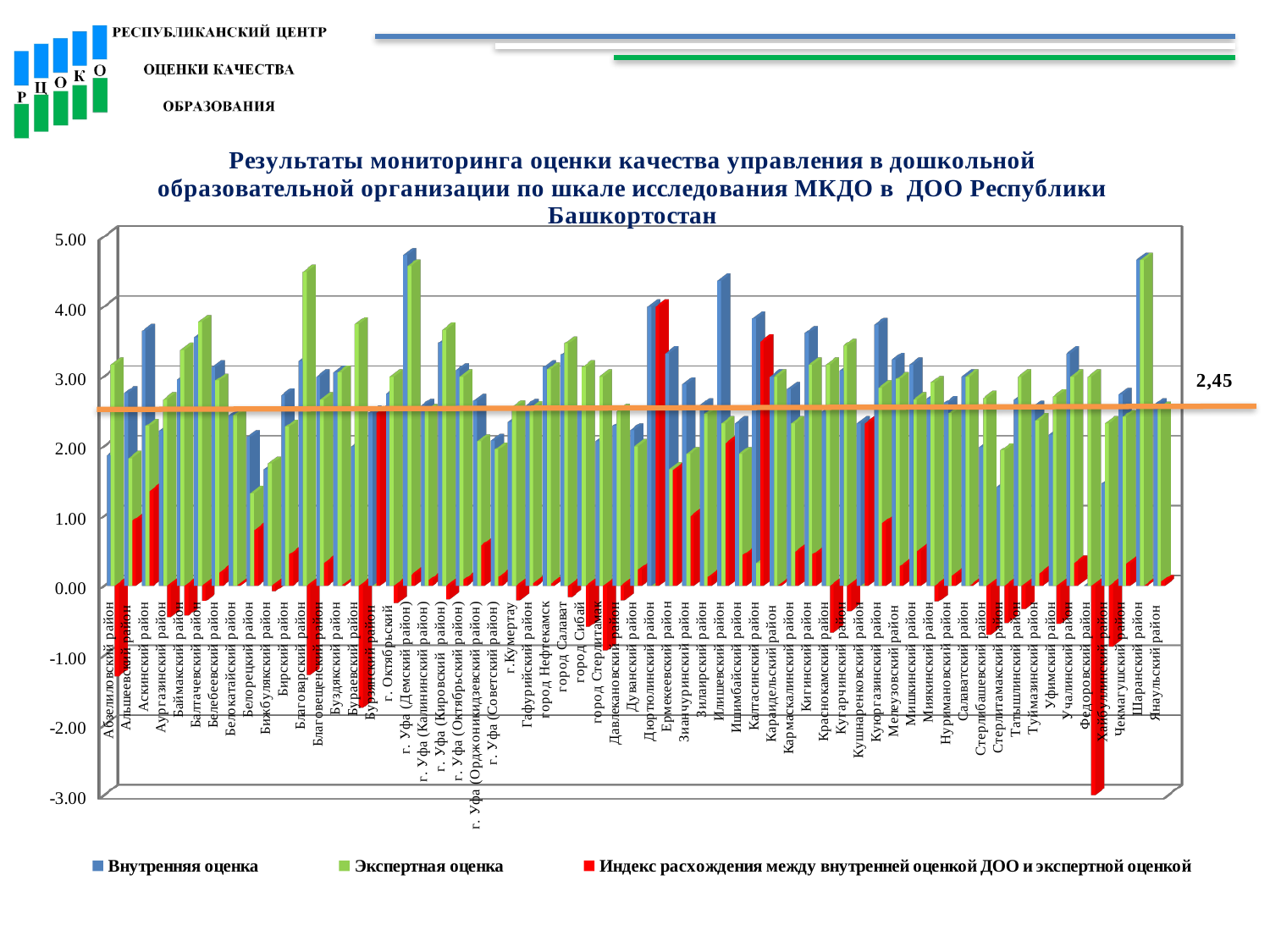
Which category has the lowest value for Индекс расхождения между внутренней оценкой ДОО и экспертной оценкой? Федоровский район What kind of chart is shown on the slide? Bar chart For Белорецкий район, which is larger: the Внутренняя оценка or the Экспертная оценка? Внутренняя оценка How many series does the legend list? 3 Is the Экспертная оценка value for Благоварский район greater or less than 4.00? greater Is the Индекс расхождения value for Дюртюлинский район greater or less than 3.00? greater Is the Индекс расхождения value for Карайдельский район greater or less than 3.00? less What value is labelled on the horizontal reference line drawn across the chart? 2,45 Which series is shown in red according to the legend? Индекс расхождения между внутренней оценкой ДОО и экспертной оценкой